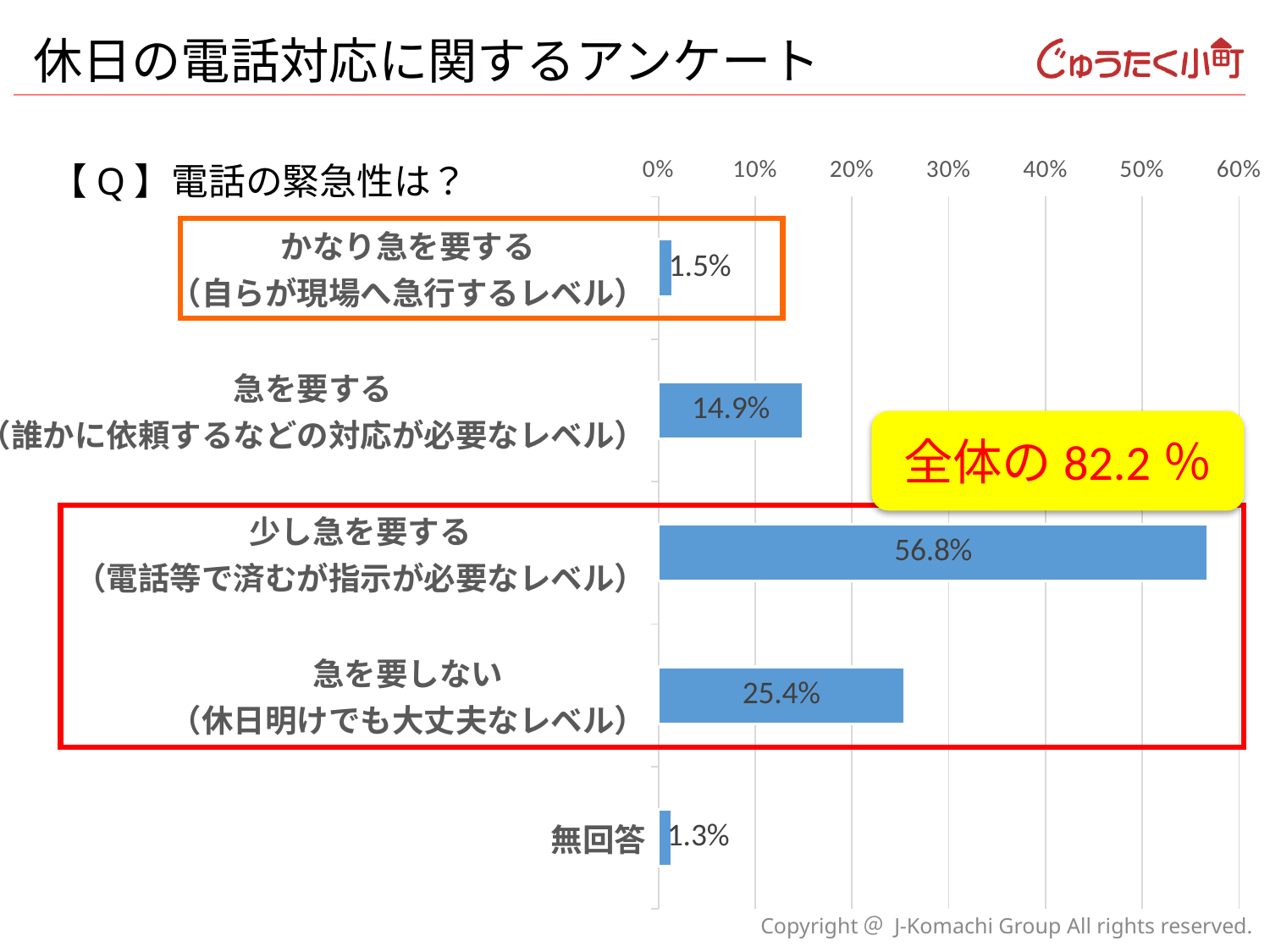
Which category has the highest value? 少し急を要する（電話等で済むが指示が必要なレベル） What is the difference between the values for 少し急を要する and 急を要しない? 31.4% Is the value for 少し急を要する greater or less than 50%? greater What is the value for かなり急を要する（自らが現場へ急行するレベル）? 1.5% What percentage is shown in the yellow callout box on the chart? 82.2％ What is the difference between the values for 急を要する and かなり急を要する? 13.4% How many categories are shown in the chart? 5 What is the value for 無回答? 1.3% Which is larger, the value for 急を要する or the value for 急を要しない? 急を要しない What kind of chart is shown on the slide? bar chart What is the value for 少し急を要する（電話等で済むが指示が必要なレベル）? 56.8% What is the value for 急を要しない（休日明けでも大丈夫なレベル）? 25.4%